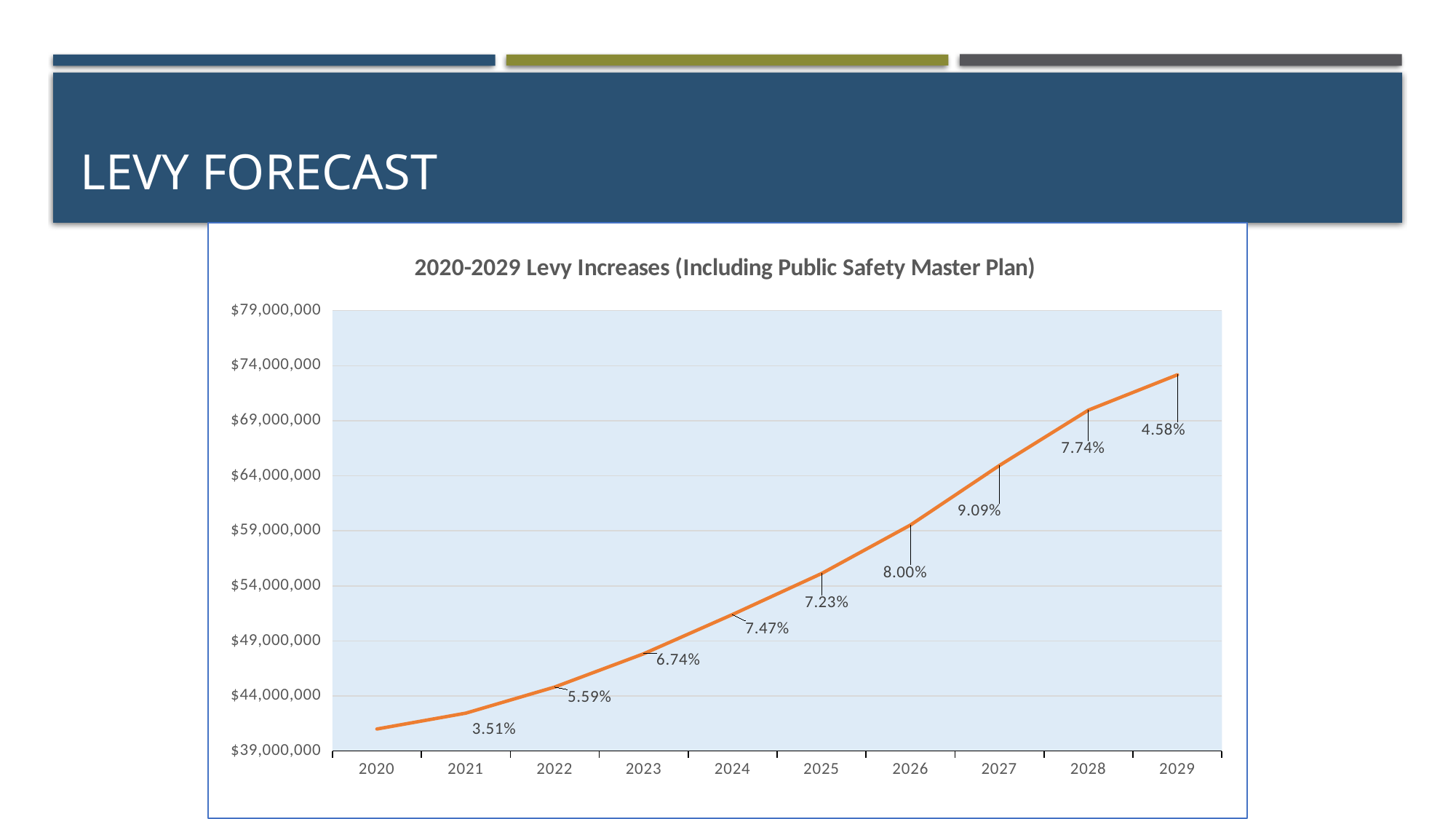
Which year has the lowest labelled percentage increase? 2021 Do the levy values rise or fall from 2020 to 2029? rise Which year has the larger labelled percentage increase, 2028 or 2029? 2028 What percentage increase is labelled for 2021? 3.51% What percentage increase is labelled for 2027? 9.09% What kind of chart is shown on the slide? line chart What is the title of the chart? 2020-2029 Levy Increases (Including Public Safety Master Plan) What is the difference between the labelled percentage increases for 2027 and 2026? 1.09% How many years are plotted along the x axis of the chart? 10 Which year has the highest labelled percentage increase? 2027 Is the levy value for 2029 greater or less than $69,000,000? greater What percentage increase is labelled for 2024? 7.47%